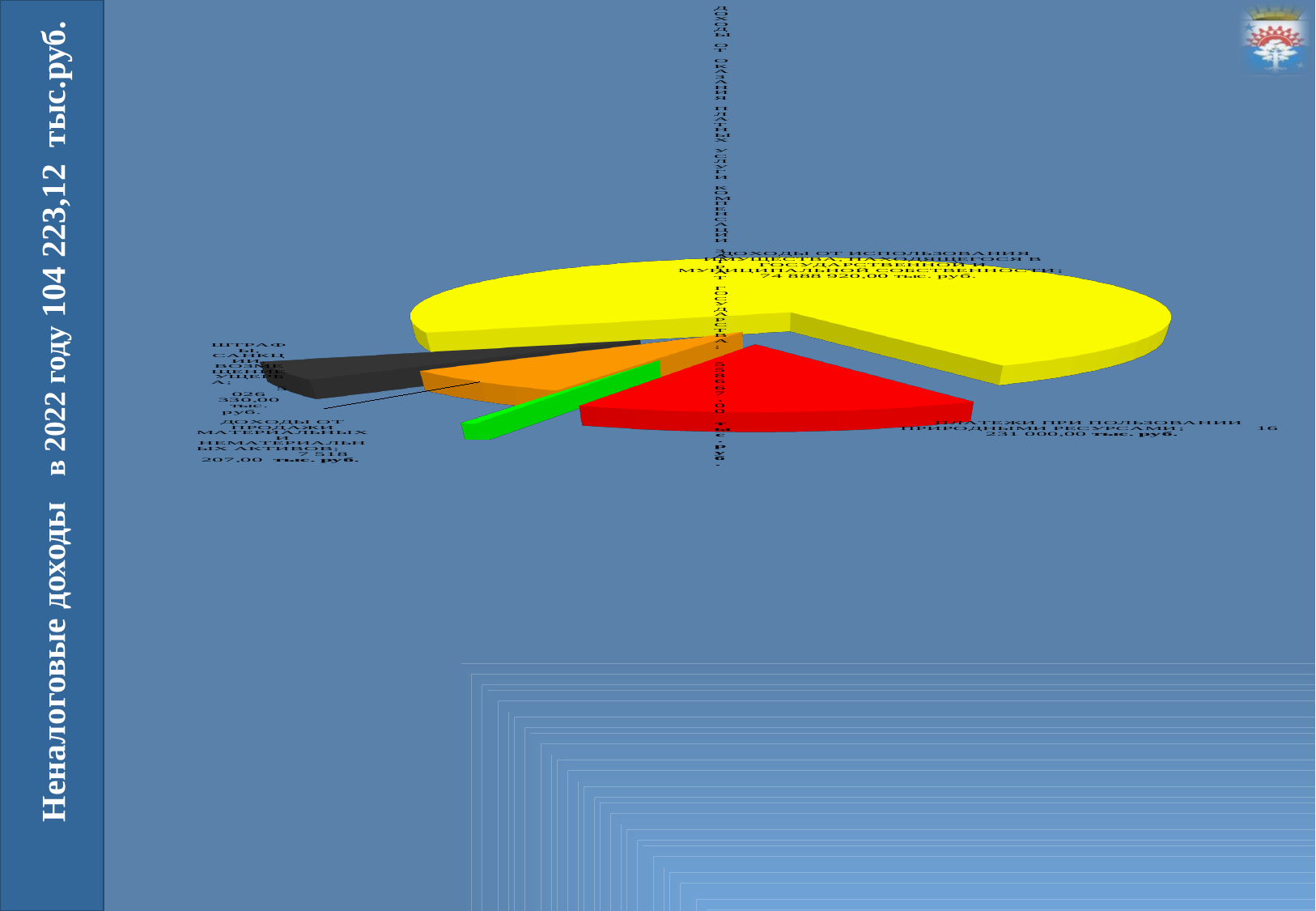
What is the value shown for «Доходы от использования имущества, находящегося в государственной и муниципальной собственности»? 74 888 920,00 тыс. руб. Which category has the smallest slice of the pie? Доходы от оказания платных услуг и компенсации затрат государства Which is larger: «Доходы от использования имущества» or «Платежи при пользовании природными ресурсами»? Доходы от использования имущества Which category has the largest slice of the pie? Доходы от использования имущества, находящегося в государственной и муниципальной собственности What colour is the largest slice of the pie chart? Yellow What is the value shown for «Доходы от продажи материальных и нематериальных активов»? 7 518 207,00 тыс. руб. What type of chart is shown on the slide? Pie chart What is the value shown for «Платежи при пользовании природными ресурсами»? 16 231 000,00 тыс. руб. Which is larger: «Платежи при пользовании природными ресурсами» or «Доходы от продажи материальных и нематериальных активов»? Платежи при пользовании природными ресурсами What is the difference between «Доходы от использования имущества» (74 888 920,00) and «Платежи при пользовании природными ресурсами» (16 231 000,00)? 58 657 920,00 тыс. руб. What total amount of non-tax revenue for 2022 is stated in the slide title? 104 223,12 тыс.руб. How many slices does the pie chart have? 5